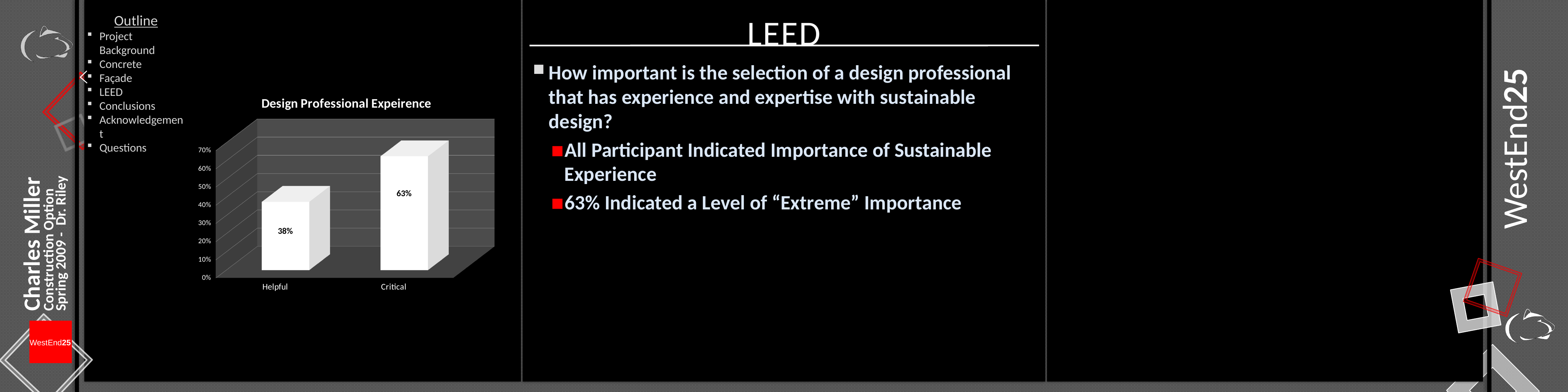
Which is larger, the value for Helpful or the value for Critical? Critical What is the difference between the values for Critical and Helpful? 25% What is the value for Helpful in the Design Professional Expeirence chart? 38% Which category has the lowest value in the chart? Helpful What is the highest value shown on the chart's vertical axis? 70% What kind of chart is shown on the slide? bar chart What is the value for Critical in the Design Professional Expeirence chart? 63% Which category has the highest value in the chart? Critical Is the value for Critical greater or less than 50%? greater Is the value for Helpful greater or less than 40%? less How many categories are shown in the chart? 2 What is the title of the chart? Design Professional Expeirence